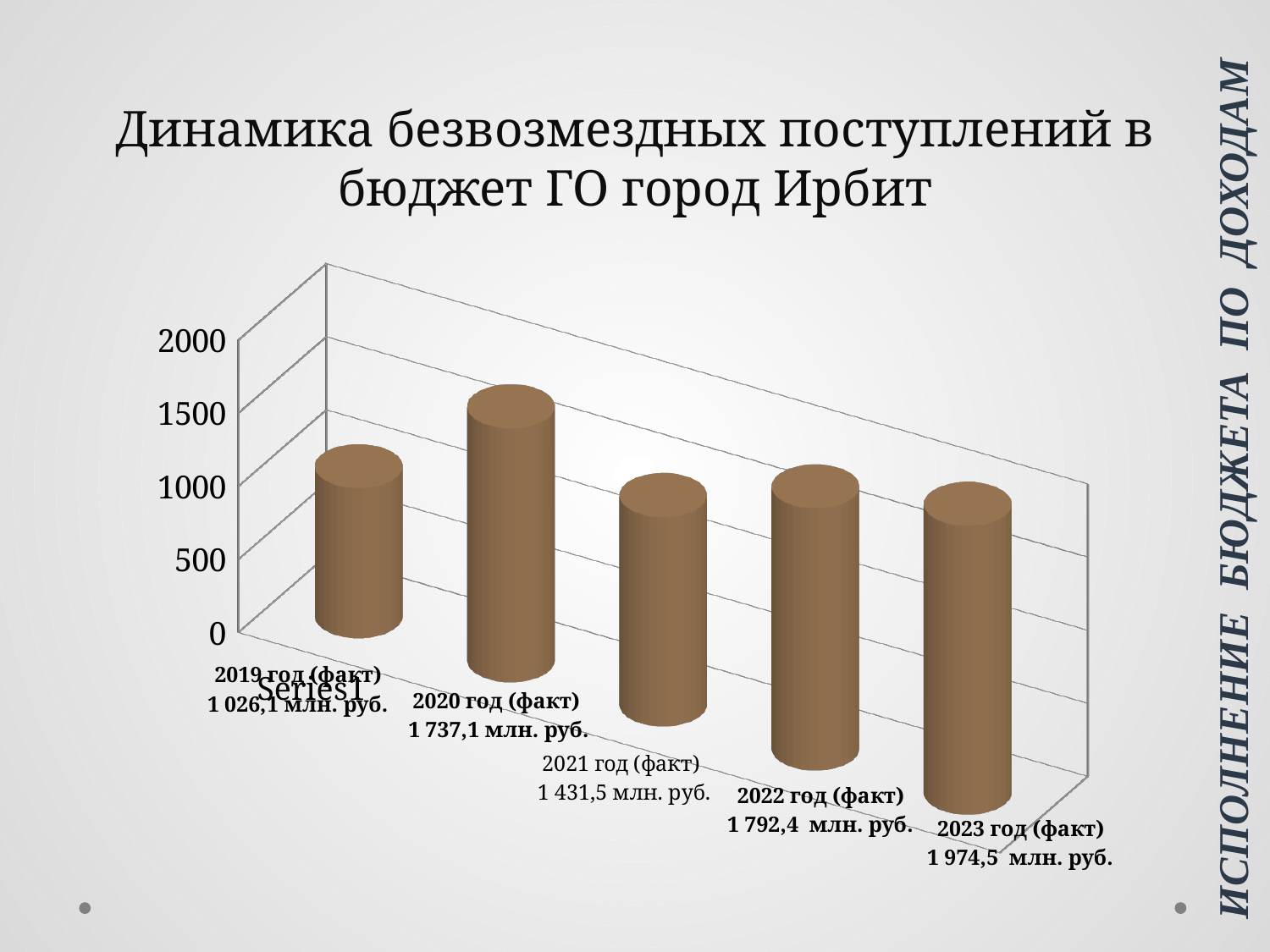
What is the difference between the values for 2022 год (факт) and 2021 год (факт)? 360,9 млн. руб. What is the title of the chart? Динамика безвозмездных поступлений в бюджет ГО город Ирбит What is the value for 2021 год (факт)? 1 431,5 млн. руб. Is the value for 2019 год (факт) greater or less than 1500? less Which year has the highest value? 2023 год (факт) What kind of chart is shown on the slide? bar chart Which is larger, the value for 2020 год (факт) or 2021 год (факт)? 2020 год (факт) What is the value for 2023 год (факт)? 1 974,5 млн. руб. What is the difference between the values for 2023 год (факт) and 2019 год (факт)? 948,4 млн. руб. Which year has the lowest value? 2019 год (факт) What is the value for 2019 год (факт)? 1 026,1 млн. руб. How many bars are shown in the chart? 5